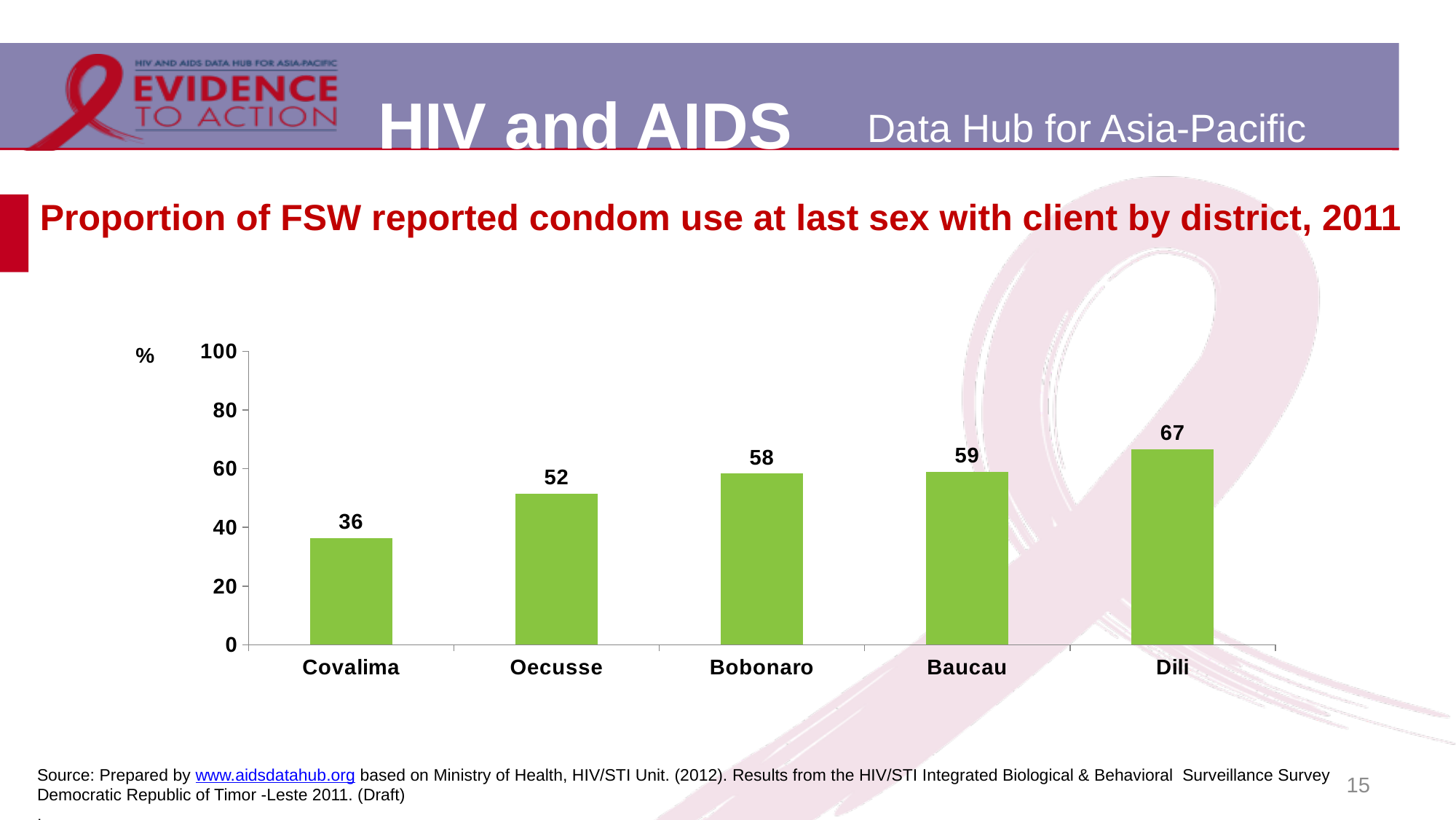
What kind of chart is shown on the slide? bar chart How many districts are shown on the chart? 5 What is the value for Dili? 67 What is the value for Bobonaro? 58 What is the difference between the values for Dili and Covalima? 31 Is the value for Baucau greater or less than 40? greater Which district has the lowest value? Covalima What unit is shown on the y axis of the chart? % Which is larger, the value for Oecusse or the value for Bobonaro? Bobonaro Do the values rise or fall from Covalima to Dili along the x axis? rise What is the value for Covalima? 36 Which district has the highest value? Dili